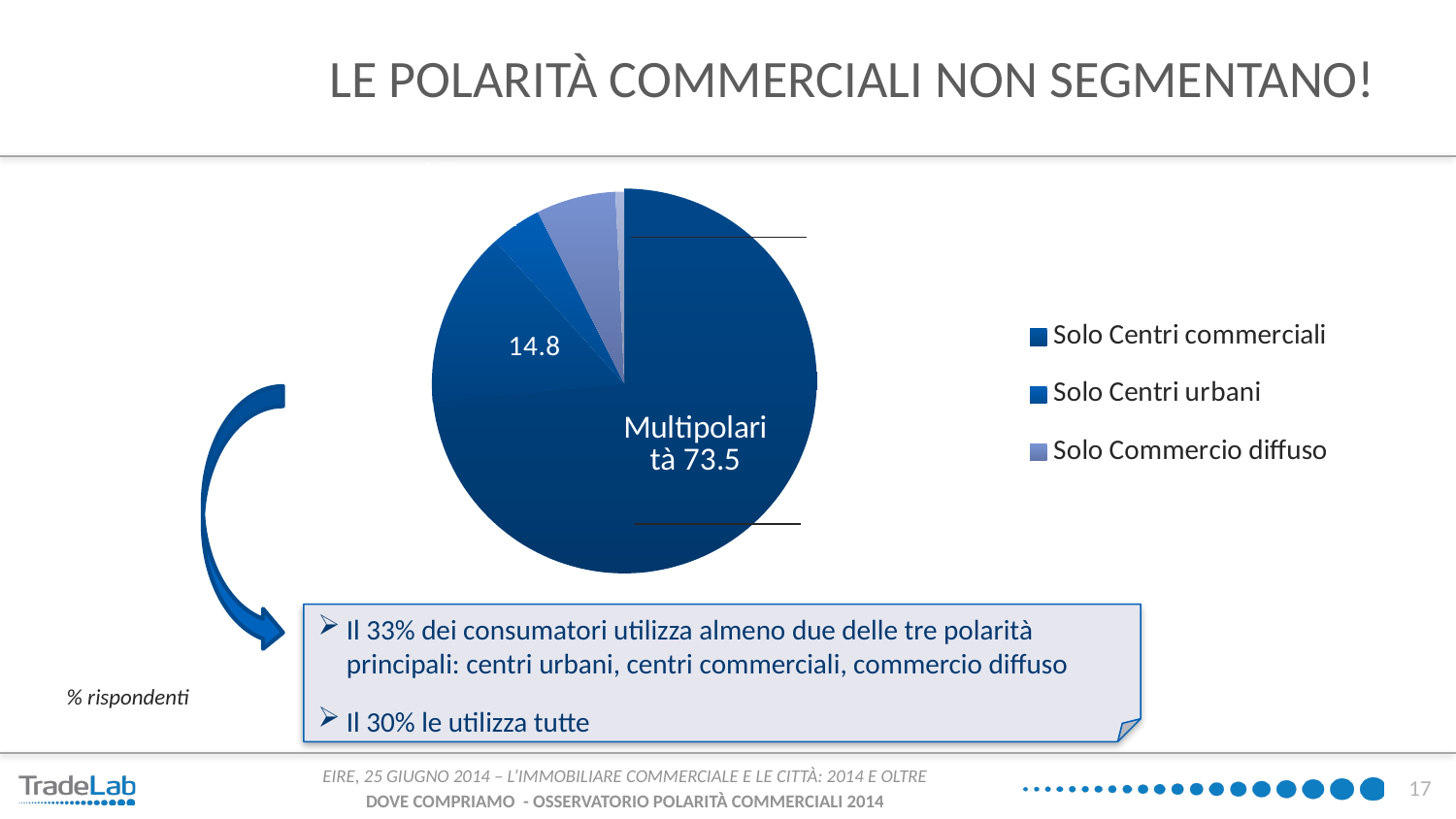
What kind of chart is shown on the slide? pie chart What unit note is printed at the bottom left of the chart area? % rispondenti How many slices does the pie chart have? 5 Which slice of the pie chart is the largest? Multipolarità Is the Multipolarità slice more or less than half of the pie? more What are the three entries listed in the pie chart's legend? Solo Centri commerciali, Solo Centri urbani, Solo Commercio diffuso Which is larger in the pie chart: the Multipolarità slice or the Solo Centri urbani slice? Multipolarità How many entries does the legend of the pie chart list? 3 What value is shown for the Multipolarità slice of the pie chart? 73.5